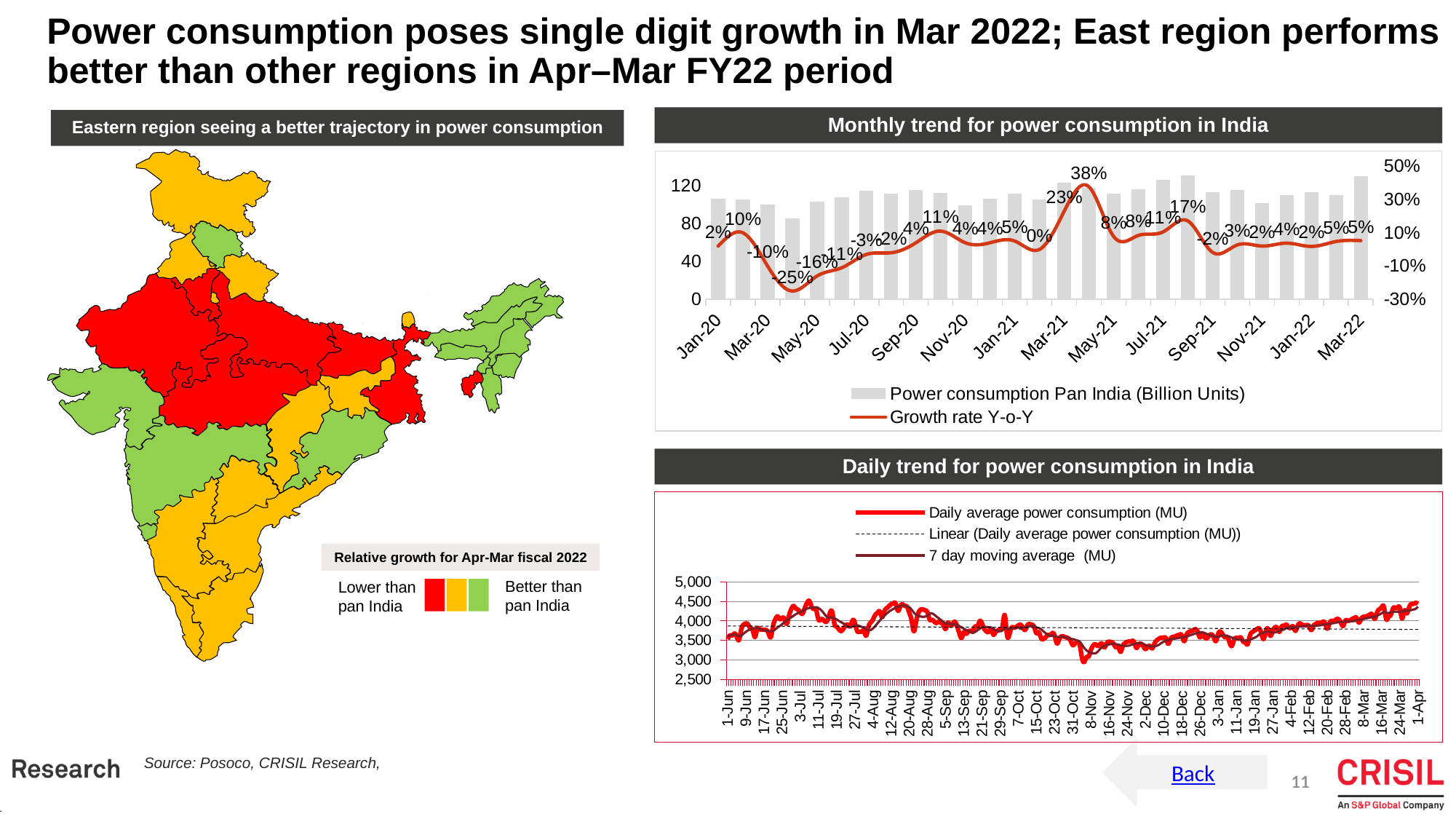
What kind of chart is the 'Daily trend for power consumption in India' chart? A line chart How many series does the legend of the 'Monthly trend for power consumption in India' chart list? 2 In the 'Monthly trend for power consumption in India' chart, which month has the lowest Y-o-Y growth rate? Apr-20 What kind of chart is the 'Monthly trend for power consumption in India' chart? A combined bar and line chart How many series does the legend of the 'Daily trend for power consumption in India' chart list? 3 In the 'Monthly trend for power consumption in India' chart, what is the Y-o-Y growth rate for Apr-21? 38% In the 'Monthly trend for power consumption in India' chart, what is the Y-o-Y growth rate for Mar-22? 5% In the 'Monthly trend for power consumption in India' chart, what is the Y-o-Y growth rate for Apr-20? -25% In the 'Monthly trend for power consumption in India' chart, which has the higher Y-o-Y growth rate, Jul-21 or Aug-21? Aug-21 In the 'Monthly trend for power consumption in India' chart, which month has the highest Y-o-Y growth rate? Apr-21 In the 'Monthly trend for power consumption in India' chart, by how many percentage points does the growth rate for Apr-21 exceed that for Mar-21? 15 percentage points In the 'Daily trend for power consumption in India' chart, is the daily average power consumption around 8-Nov greater or less than 3,500? less